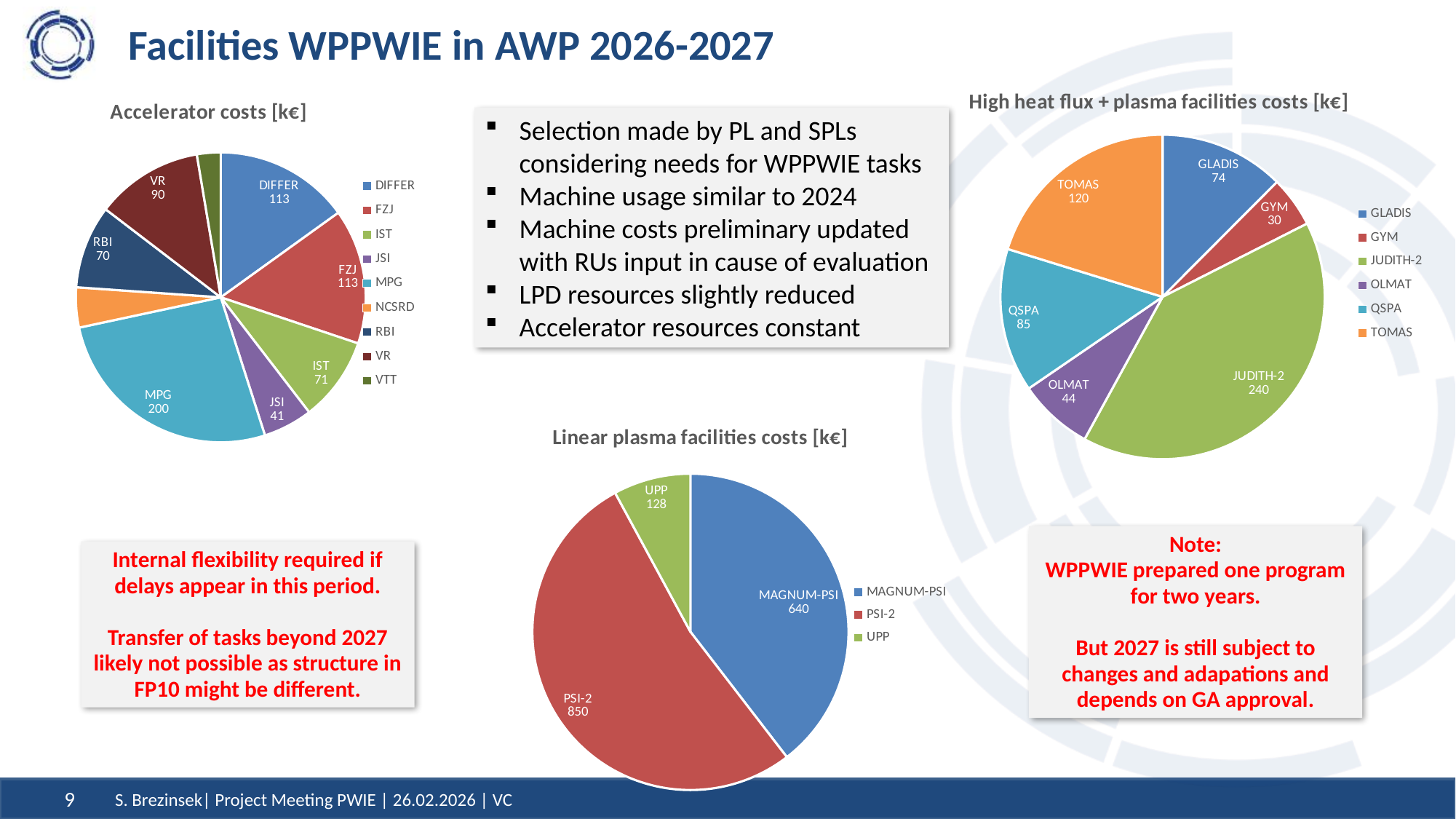
In the 'Linear plasma facilities costs [k€]' chart, what is the difference between PSI-2 and MAGNUM-PSI? 210 In the 'Linear plasma facilities costs [k€]' chart, what is the value for PSI-2? 850 In the 'High heat flux + plasma facilities costs [k€]' chart, what is the value for QSPA? 85 In the 'Accelerator costs [k€]' chart, what is the difference between the values for VR and RBI? 20 In the 'High heat flux + plasma facilities costs [k€]' chart, which category has the lowest value? GYM In the 'Accelerator costs [k€]' chart, what is the value for MPG? 200 What kind of chart is the 'Linear plasma facilities costs [k€]' chart? Pie chart In the 'High heat flux + plasma facilities costs [k€]' chart, which is larger, TOMAS or GLADIS? TOMAS In the 'Accelerator costs [k€]' chart, which category has the highest value? MPG In the 'High heat flux + plasma facilities costs [k€]' chart, what is the difference between JUDITH-2 and OLMAT? 196 How many charts are shown on the slide? 3 In the 'Accelerator costs [k€]' chart, how many categories does the legend list? 9